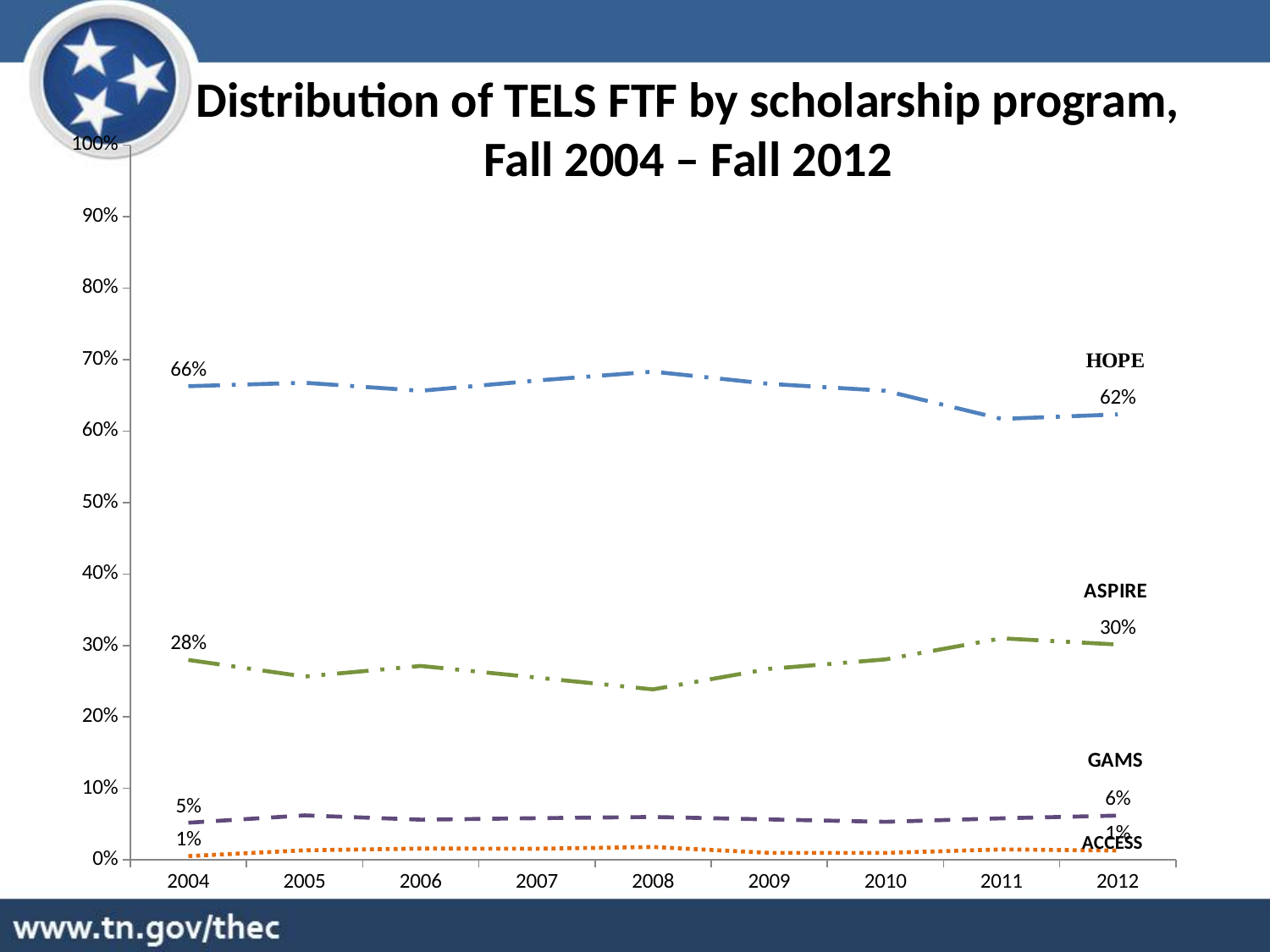
What kind of chart is shown on the slide? line chart Does the HOPE line rise or fall from 2010 to 2011? fall Is the value for ASPIRE in 2008 greater or less than 30%? less What is the value for ACCESS in 2012? 1% Which scholarship program has the highest share in 2012? HOPE Which scholarship program has the lowest share in 2004? ACCESS What is the value for GAMS in 2004? 5% By how many percentage points did the HOPE share change from 2004 to 2012? 4% What is the value for HOPE in 2012? 62% How many years are plotted along the x axis? 9 What is the value for ASPIRE in 2012? 30% What is the value for HOPE in 2004? 66%